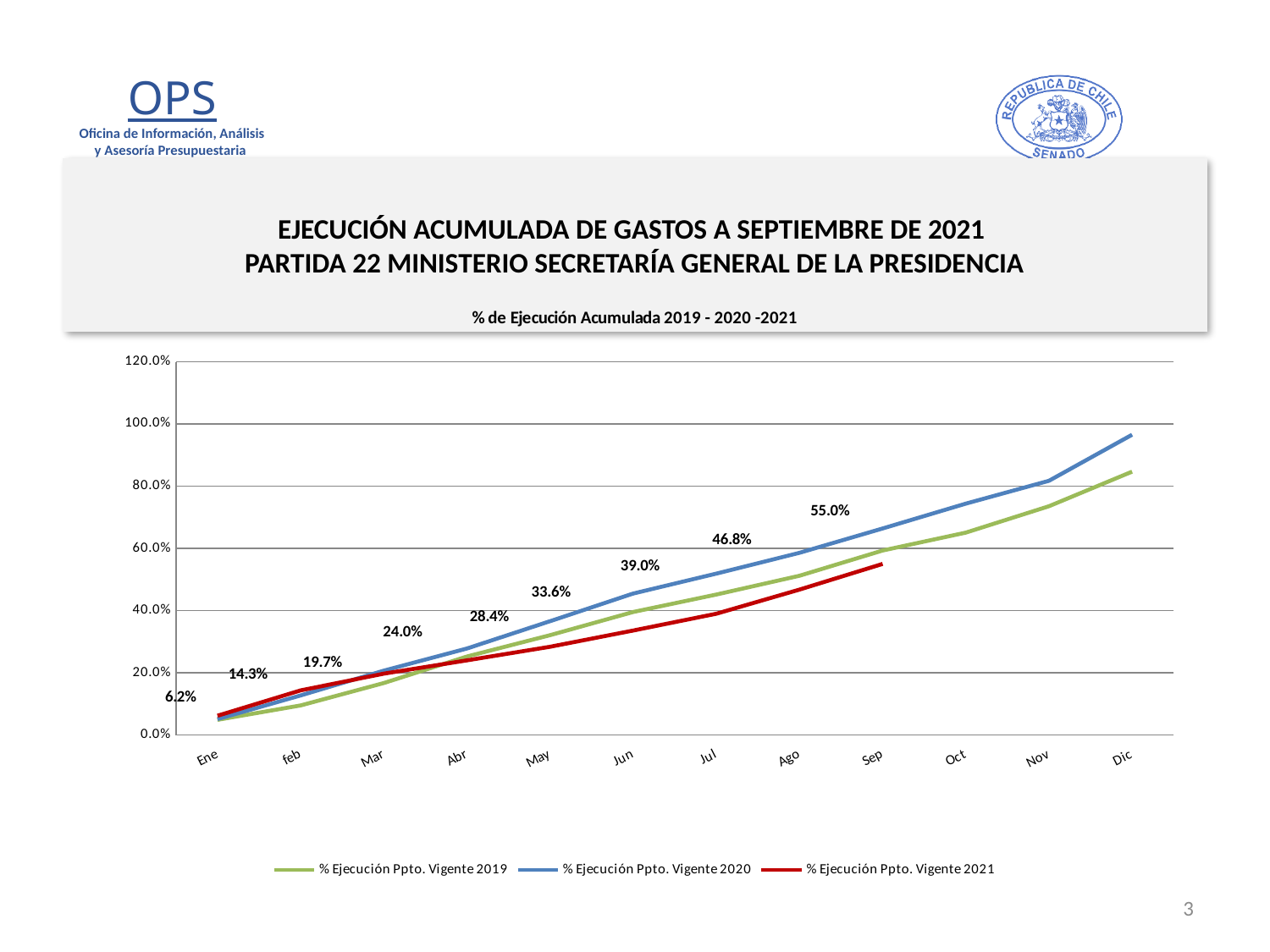
Which series is higher in Dic, % Ejecución Ppto. Vigente 2019 or % Ejecución Ppto. Vigente 2020? % Ejecución Ppto. Vigente 2020 What is the value for % Ejecución Ppto. Vigente 2021 in Sep? 55.0% How many months are shown along the x axis? 12 What is the difference between the 2021 values for Sep and Ago? 8.2% Is the value for % Ejecución Ppto. Vigente 2020 in Dic greater or less than 80.0%? greater What is the value for % Ejecución Ppto. Vigente 2021 in Jul? 39.0% What is the value for % Ejecución Ppto. Vigente 2021 in Ene? 6.2% What is the value for % Ejecución Ppto. Vigente 2021 in May? 28.4% How many series does the legend list? 3 What type of chart is shown on the slide? Line chart What is the difference between the 2021 values for Abr and Mar? 4.3% Do the values for % Ejecución Ppto. Vigente 2021 rise or fall from Ene to Sep? Rise